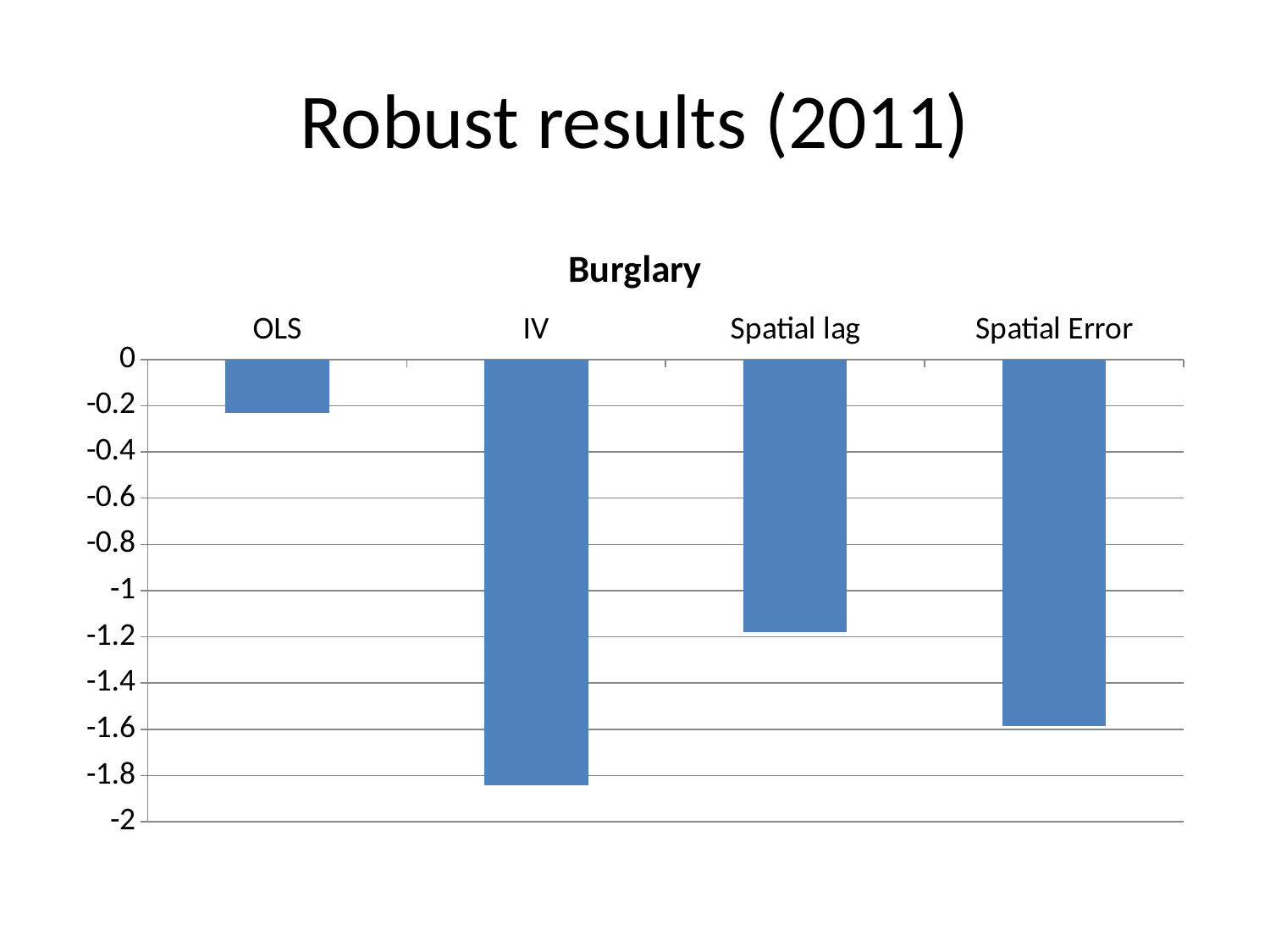
Is the value for Spatial lag greater or less than -1? less Which has the more negative value, Spatial lag or Spatial Error? Spatial Error Which category has the most negative value (the bar extending furthest below zero)? IV Is the value for IV greater or less than -1.6? less Which category has the value closest to zero (the highest value)? OLS Which has the more negative value, IV or Spatial Error? IV What is the title of the chart? Burglary Is the value for OLS greater or less than -0.4? greater What kind of chart is shown on the slide? bar chart What is the lowest value shown on the vertical axis? -2 How many categories are plotted in the Burglary chart? 4